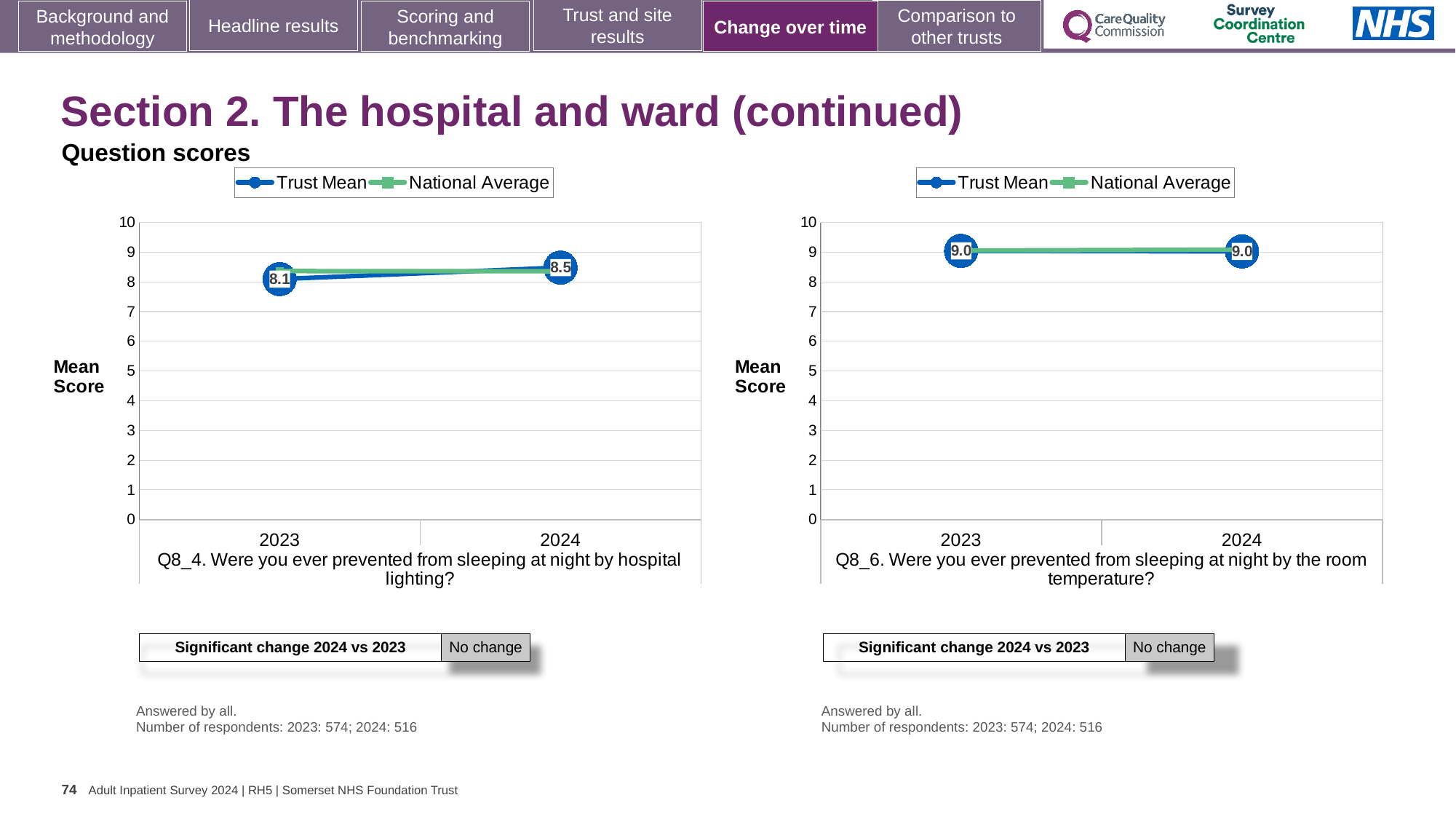
In the Q8_4 hospital lighting chart, what is the Trust Mean for 2024? 8.5 In the Q8_6 room temperature chart, does the Trust Mean rise, fall or stay the same from 2023 to 2024? stay the same In the Q8_4 hospital lighting chart, which year has the higher Trust Mean, 2023 or 2024? 2024 What kind of chart is the Q8_4 hospital lighting chart? line chart How many series does the legend of the Q8_6 room temperature chart list? 2 In the Q8_6 room temperature chart, is the National Average for 2024 greater or less than 8? greater In the Q8_6 room temperature chart, what is the Trust Mean for 2024? 9.0 In the Q8_4 hospital lighting chart, does the Trust Mean rise or fall from 2023 to 2024? rise In the Q8_4 hospital lighting chart, by how much did the Trust Mean change from 2023 to 2024? 0.4 How many years are plotted on the x axis of the Q8_4 hospital lighting chart? 2 In the Q8_4 hospital lighting chart, what is the Trust Mean for 2023? 8.1 In the Q8_4 hospital lighting chart, is the National Average for 2023 greater or less than 8? greater